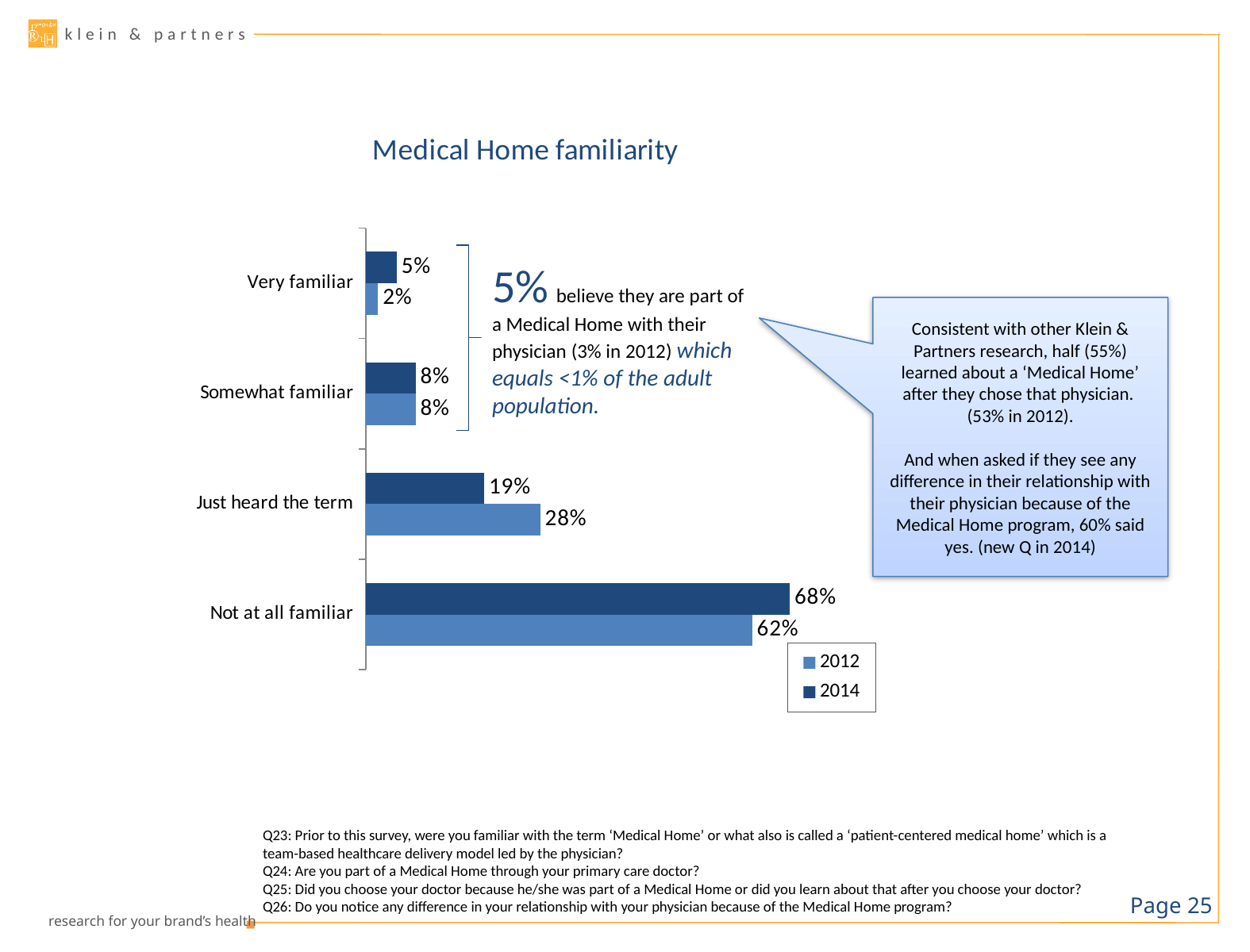
What is the 2012 value for 'Somewhat familiar'? 8% Which category has the highest 2014 value? Not at all familiar What is the 2014 value for 'Very familiar'? 5% How many categories are shown on the chart? 4 Which is larger for 'Just heard the term': the 2012 value or the 2014 value? 2012 What is the 2012 value for 'Just heard the term'? 28% How many series does the legend list? 2 What is the difference between the 2014 and 2012 values for 'Not at all familiar'? 6% What is the 2014 value for 'Not at all familiar'? 68% Which category has the lowest 2012 value? Very familiar What kind of chart is shown on the slide? Bar chart What is the title of the chart? Medical Home familiarity